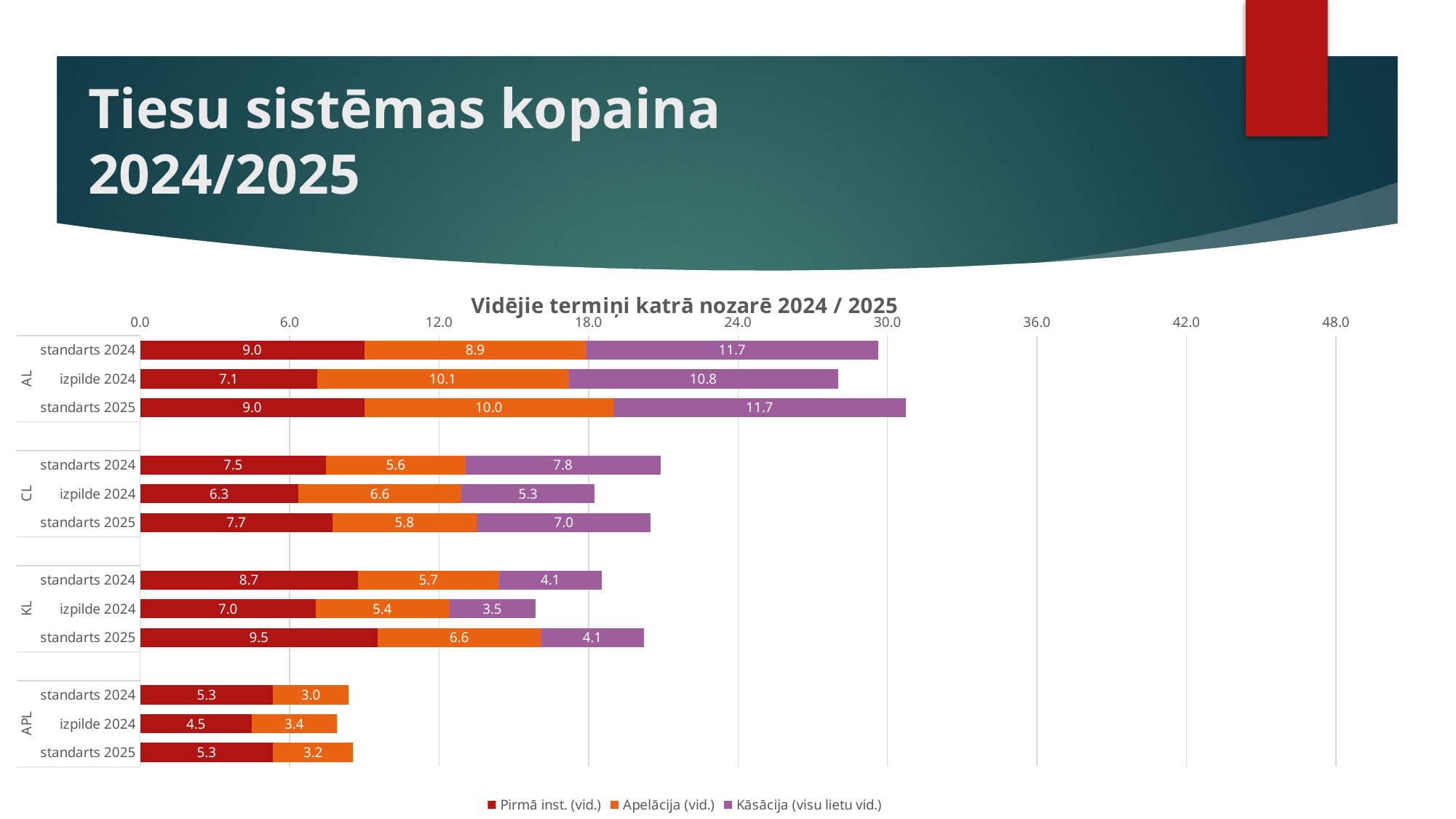
What is the Apelācija (vid.) value for CL standarts 2025? 5.8 What is the Pirmā inst. (vid.) value for AL izpilde 2024? 7.1 How many series does the chart legend list? 3 What is the total length of the stacked bar for AL standarts 2025? 30.7 What is the Kāsācija (visu lietu vid.) value for KL izpilde 2024? 3.5 Which is larger: the Apelācija (vid.) value for AL izpilde 2024 or for AL standarts 2024? AL izpilde 2024 What is the title of the chart? Vidējie termiņi katrā nozarē 2024 / 2025 What is the total length of the stacked bar for APL izpilde 2024? 7.9 Which of the four groups (AL, CL, KL, APL) has the longest stacked bar overall? AL What kind of chart is shown on the slide? Stacked bar chart What is the difference between the Pirmā inst. (vid.) values for KL standarts 2025 and KL izpilde 2024? 2.5 Is the total stacked bar for CL izpilde 2024 greater or less than 24.0? less